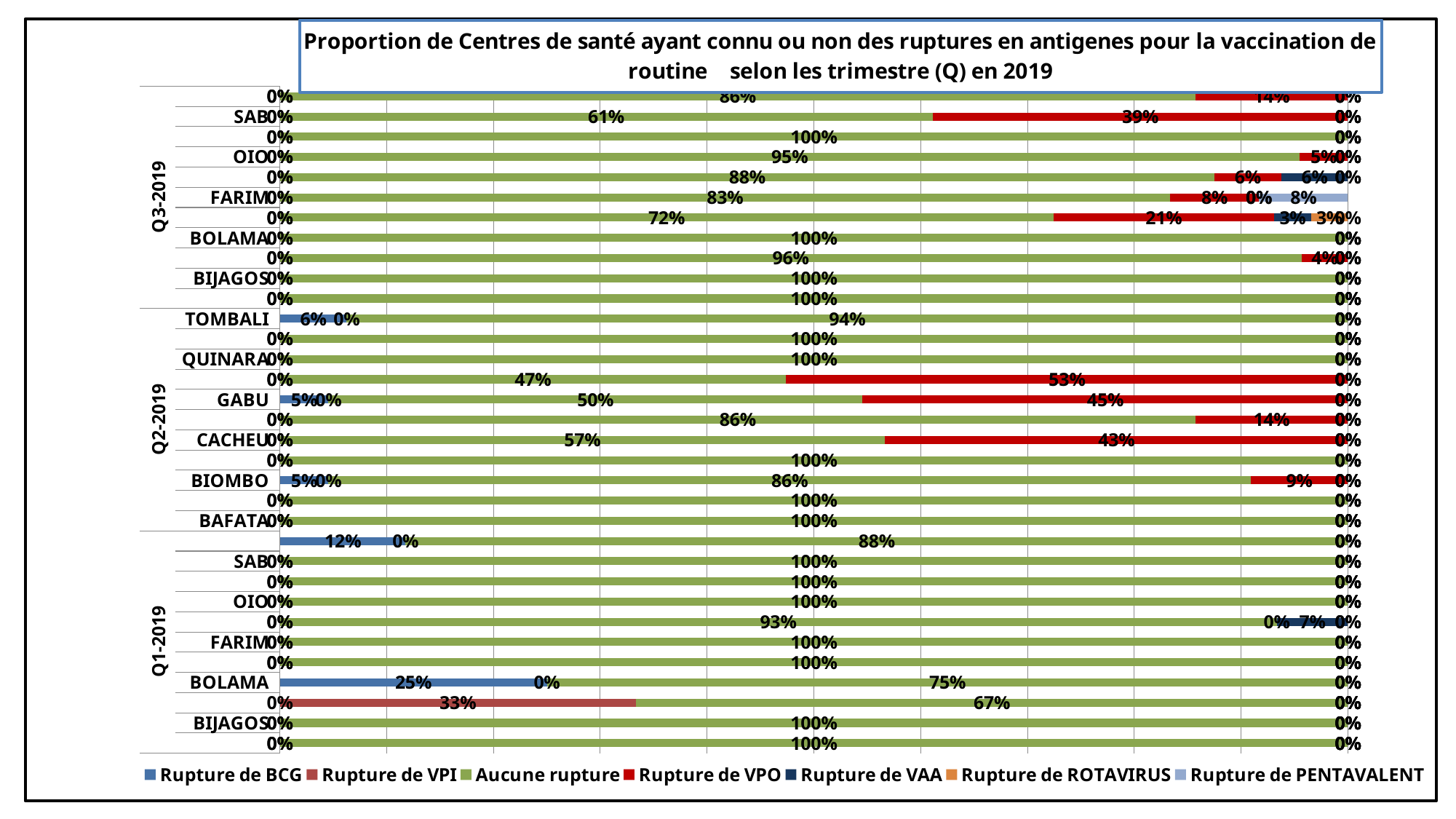
For CACHEU in Q2-2019, what is the difference between the 'Aucune rupture' value and the 'Rupture de VPO' value? 14 percentage points For SAB in Q3-2019, which is larger: 'Aucune rupture' or 'Rupture de VPO'? Aucune rupture What kind of chart is shown on the slide? Stacked bar chart What is the 'Rupture de VPO' value for SAB in Q3-2019? 39% What is the 'Aucune rupture' value for CACHEU in Q2-2019? 57% How many series does the legend list? 7 What is the 'Rupture de VPO' value for GABU in Q2-2019? 45% What is the 'Rupture de BCG' value for BOLAMA in Q1-2019? 25% Which colour represents 'Aucune rupture' in the legend? Green How many quarters (Q groups) are shown on the vertical axis? 3 What is the 'Rupture de BCG' value for TOMBALI in Q2-2019? 6% What is the 'Aucune rupture' value for SAB in Q3-2019? 61%